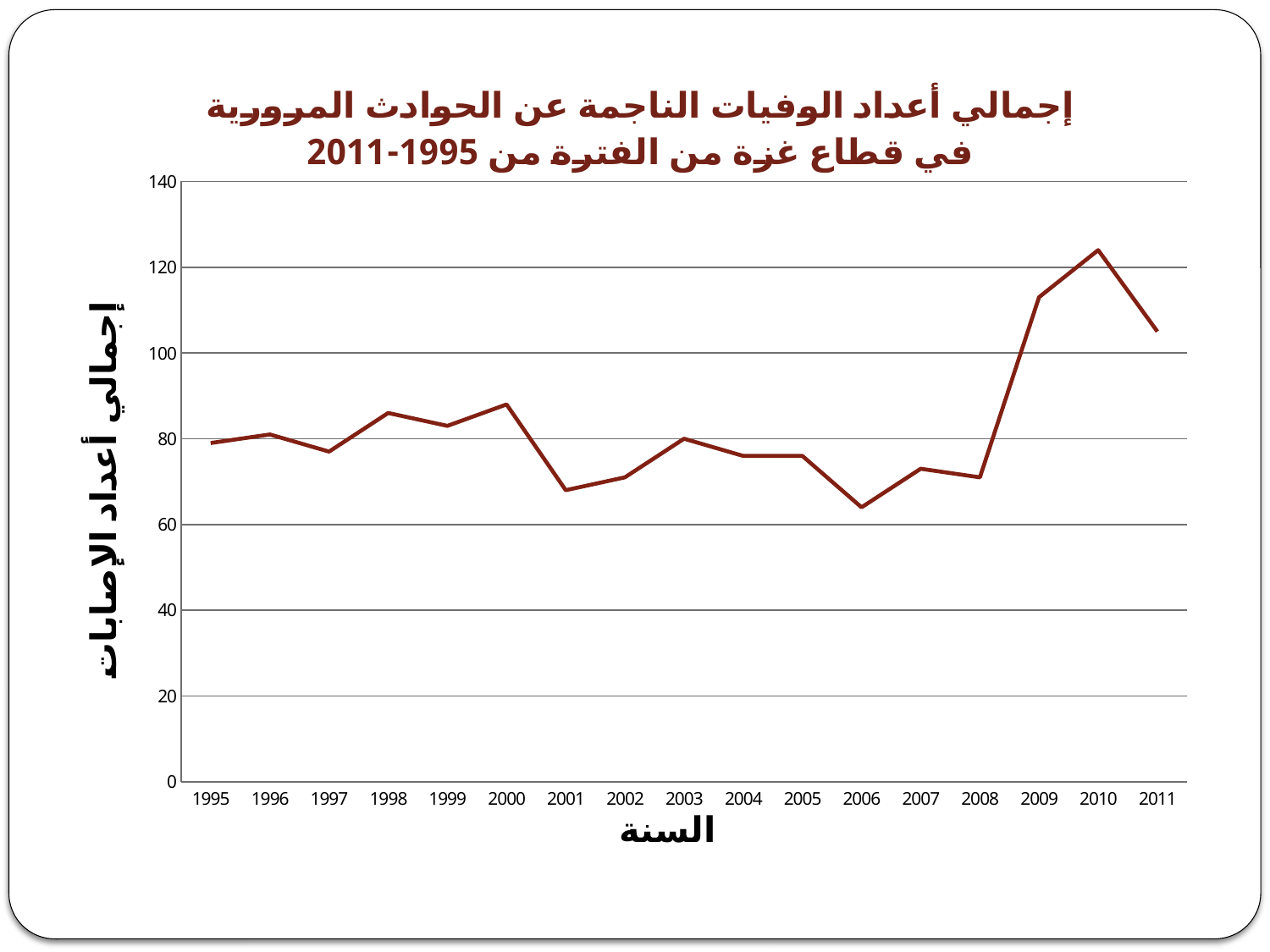
What kind of chart is shown on the slide? line chart Which year has the lowest value? 2006 Is the value for 2010 greater or less than 120? greater Which year has the larger value, 2000 or 2001? 2000 What is the label of the x axis? السنة Which year has the larger value, 2008 or 2009? 2009 Is the value for 2001 greater or less than 80? less Is the value for 2009 greater or less than 100? greater How many years are plotted along the x axis? 17 Does the line rise or fall from 2008 to 2010? rise Which year has the highest value? 2010